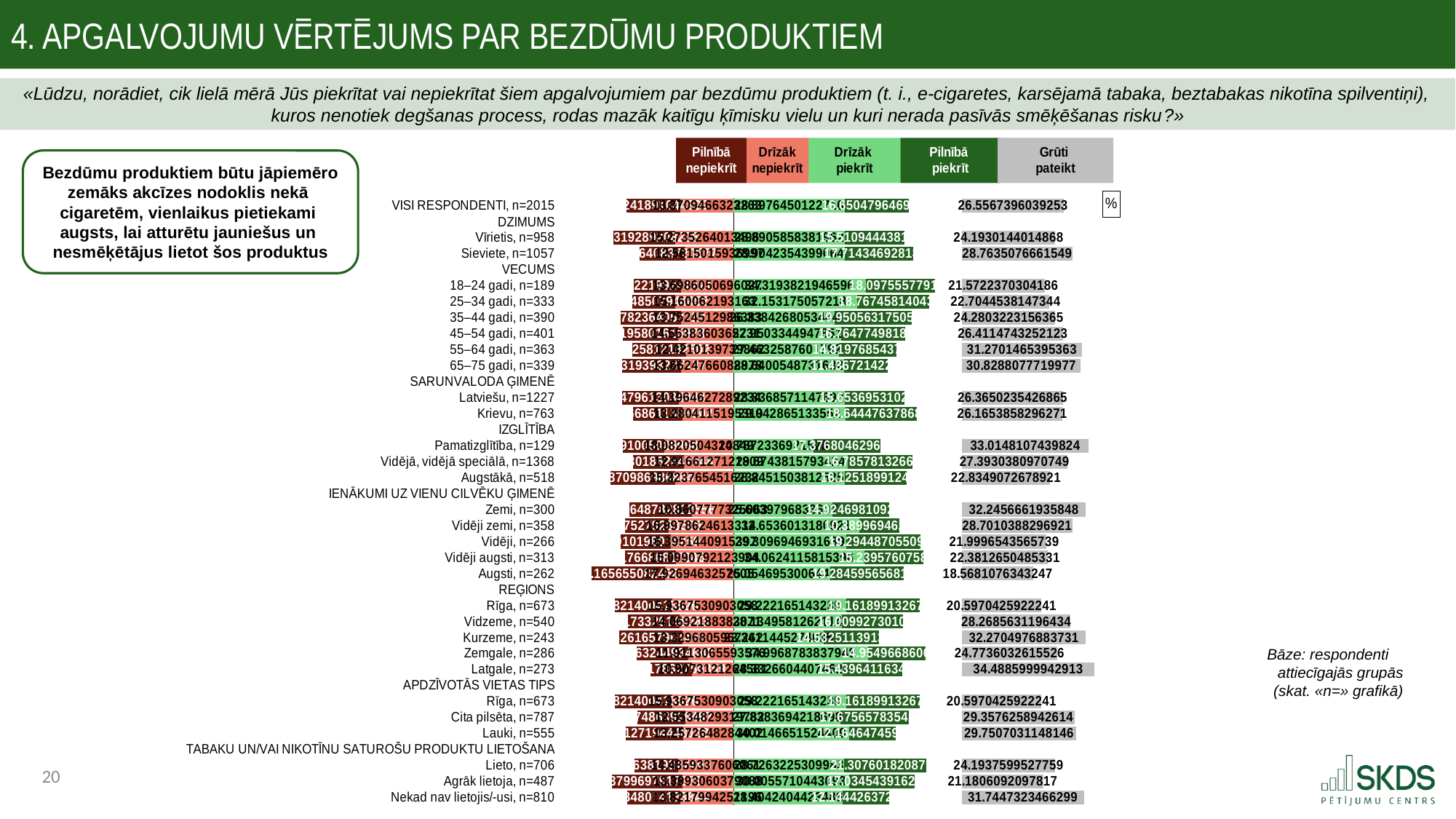
What kind of chart is shown on the slide? bar chart What is the 'Grūti pateikt' value for Augsti, n=262? 18.5681076343247 What is the difference between the 'Grūti pateikt' values for Sieviete, n=1057 and Vīrietis, n=958? 4.5704932646681 Among the REĢIONS groups, which has the highest 'Grūti pateikt' value? Latgale, n=273 How many series does the legend list? 5 What colour represents the 'Grūti pateikt' series in the legend? grey What is the 'Grūti pateikt' value for VISI RESPONDENTI, n=2015? 26.5567396039253 Does the 'Grūti pateikt' value rise or fall across the age groups from 18–24 gadi to 55–64 gadi? rise What is the 'Grūti pateikt' value for Latgale, n=273? 34.4885999942913 Among the IENĀKUMI UZ VIENU CILVĒKU ĢIMENĒ groups, which has the lowest 'Grūti pateikt' value? Augsti, n=262 How many age groups are listed under VECUMS? 6 Which has the larger 'Grūti pateikt' value: Vīrietis, n=958 or Sieviete, n=1057? Sieviete, n=1057